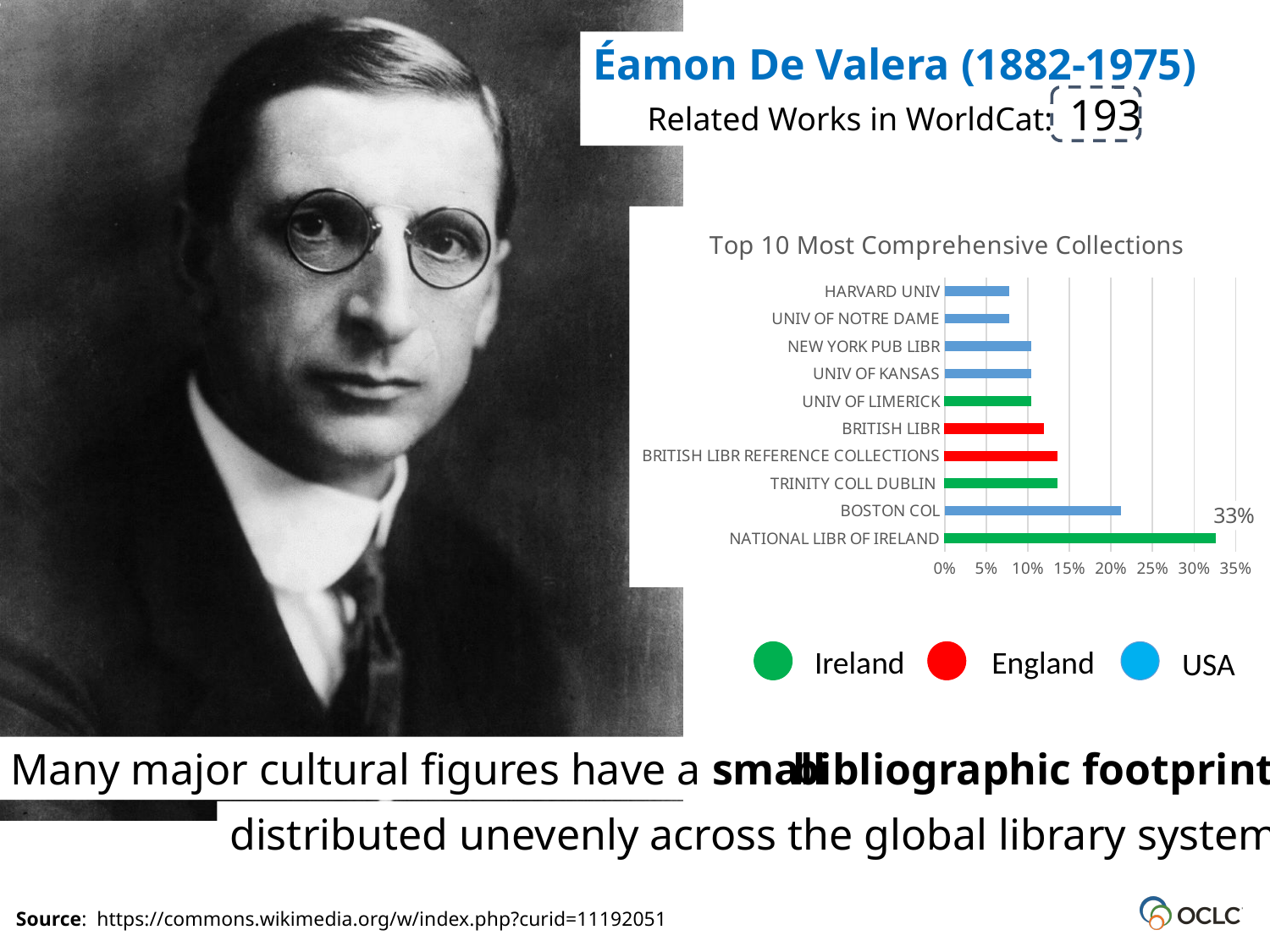
How many collections are listed in the Top 10 Most Comprehensive Collections chart? 10 Which has the larger value, BOSTON COL or TRINITY COLL DUBLIN? BOSTON COL What kind of chart is used to show the Top 10 Most Comprehensive Collections? Bar chart Is the value for HARVARD UNIV greater or less than 10%? less Is the value for TRINITY COLL DUBLIN greater or less than 15%? less What is the value shown for NATIONAL LIBR OF IRELAND in the Top 10 Most Comprehensive Collections chart? 33% Which collection has the highest value in the Top 10 Most Comprehensive Collections chart? NATIONAL LIBR OF IRELAND What is the title of the bar chart on the slide? Top 10 Most Comprehensive Collections Which has the larger value, NATIONAL LIBR OF IRELAND or BOSTON COL? NATIONAL LIBR OF IRELAND Is the value for BOSTON COL greater or less than 15%? greater How many entries does the legend of the chart list? 3 According to the legend, which colour represents Ireland? Green